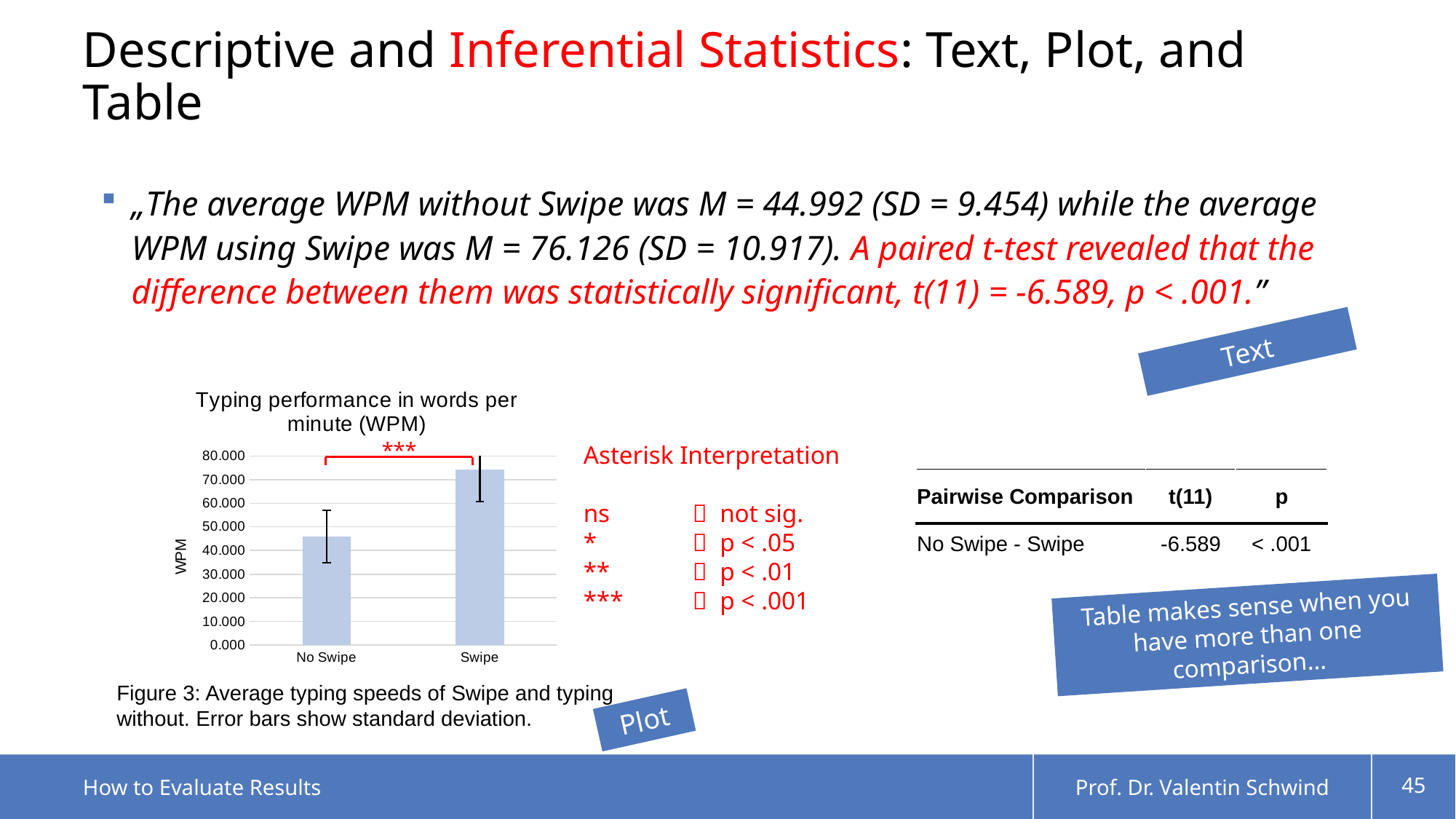
Which bar is taller, No Swipe or Swipe? Swipe Is the value for Swipe greater or less than 70.000? greater Is the value for Swipe greater or less than 80.000? less Is the value for No Swipe greater or less than 50.000? less How many categories are plotted on the x axis of the chart? 2 Do the bar values rise or fall from No Swipe to Swipe? rise Which category has the highest bar in the chart? Swipe Which category has the lowest bar in the chart? No Swipe What kind of chart is shown on the slide? bar chart What label is shown on the y axis of the chart? WPM What is the title of the chart? Typing performance in words per minute (WPM)